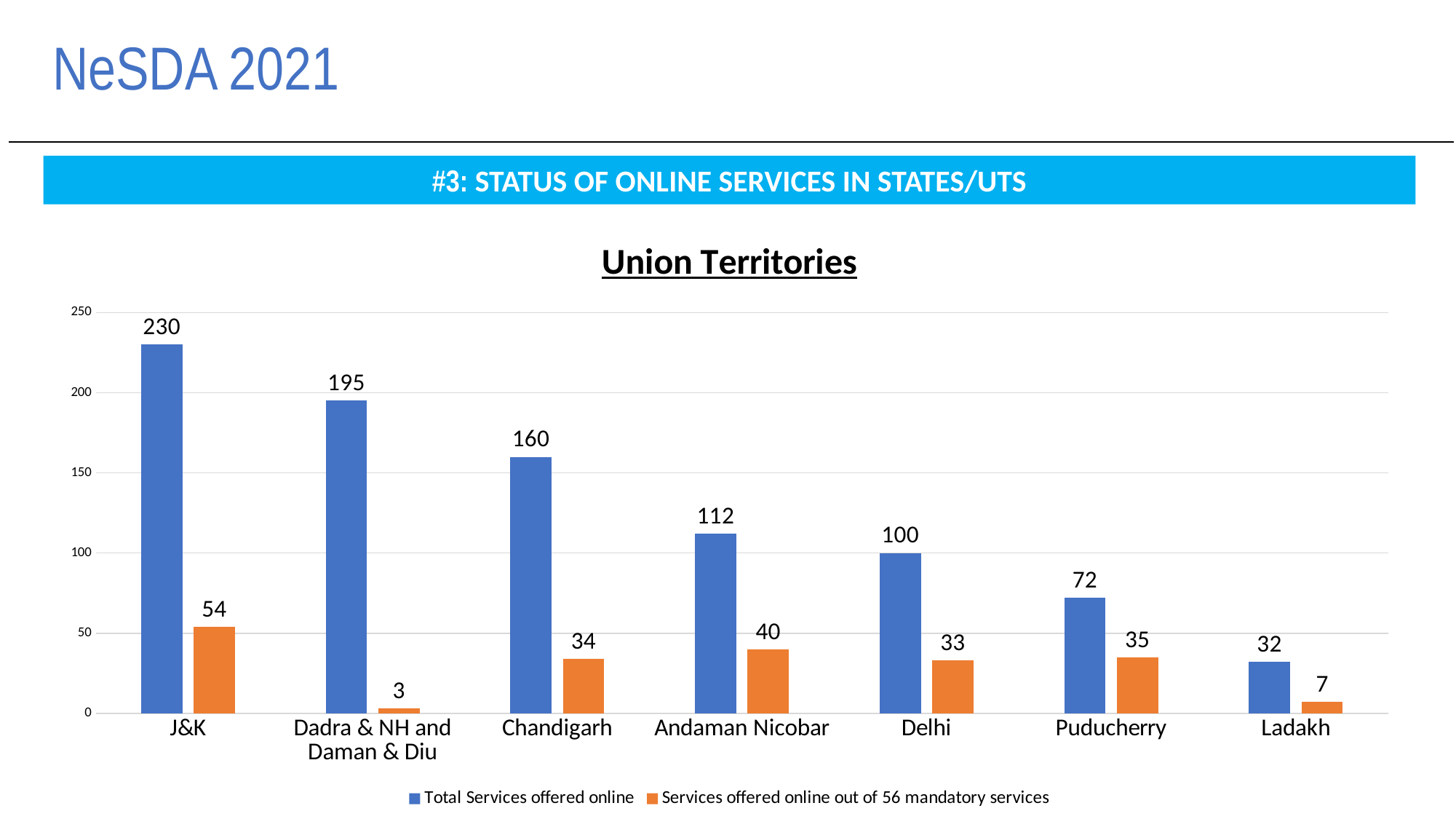
What kind of chart is shown on the slide? bar chart Which Union Territory has the lowest value for Services offered online out of 56 mandatory services? Dadra & NH and Daman & Diu What is the title of the chart? Union Territories Which has more Services offered online out of 56 mandatory services, Andaman Nicobar or Puducherry? Andaman Nicobar How many series does the legend list? 2 Which Union Territory has the highest Total Services offered online? J&K What is the value of Total Services offered online for Puducherry? 72 How many Services offered online out of 56 mandatory services does Delhi have? 33 What is the value of Total Services offered online for J&K? 230 What is the difference between Total Services offered online for Chandigarh and Andaman Nicobar? 48 How many Union Territories are shown on the x axis of the chart? 7 Is the value of Total Services offered online for Ladakh greater or less than 50? less